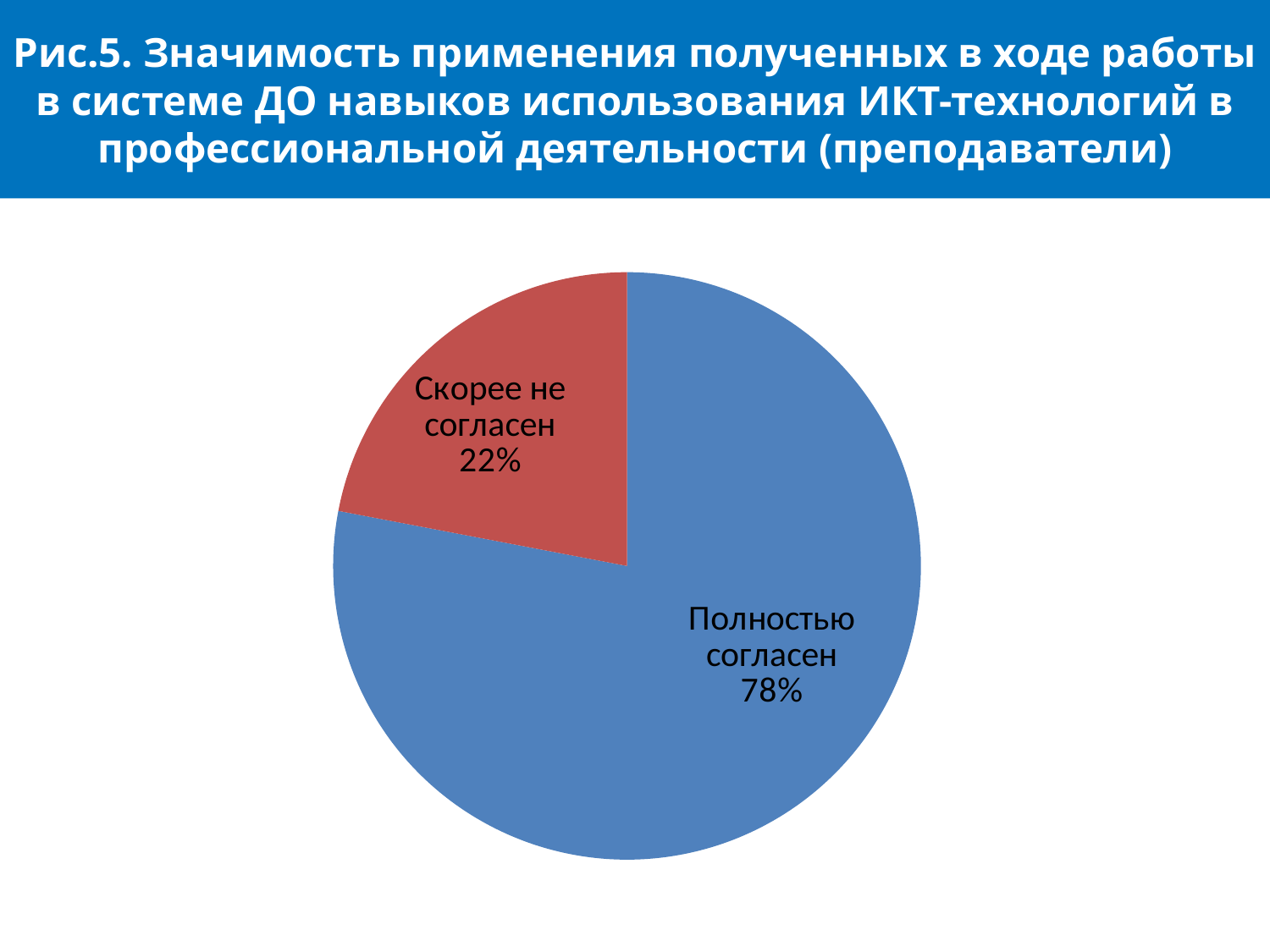
Which slice of the pie is the smallest? Скорее не согласен What kind of chart is shown on the slide? Pie chart What colour is the "Полностью согласен" slice? Blue What colour is the "Скорее не согласен" slice? Red How many slices does the pie chart have? 2 What share of the pie is labelled "Скорее не согласен"? 22% Which is larger: the "Скорее не согласен" slice or the "Полностью согласен" slice? Полностью согласен What is the total of the two slice percentages shown on the pie? 100% What share of the pie is labelled "Полностью согласен"? 78% What is the difference in percentage points between the "Полностью согласен" and "Скорее не согласен" slices? 56 Which slice of the pie is the largest? Полностью согласен